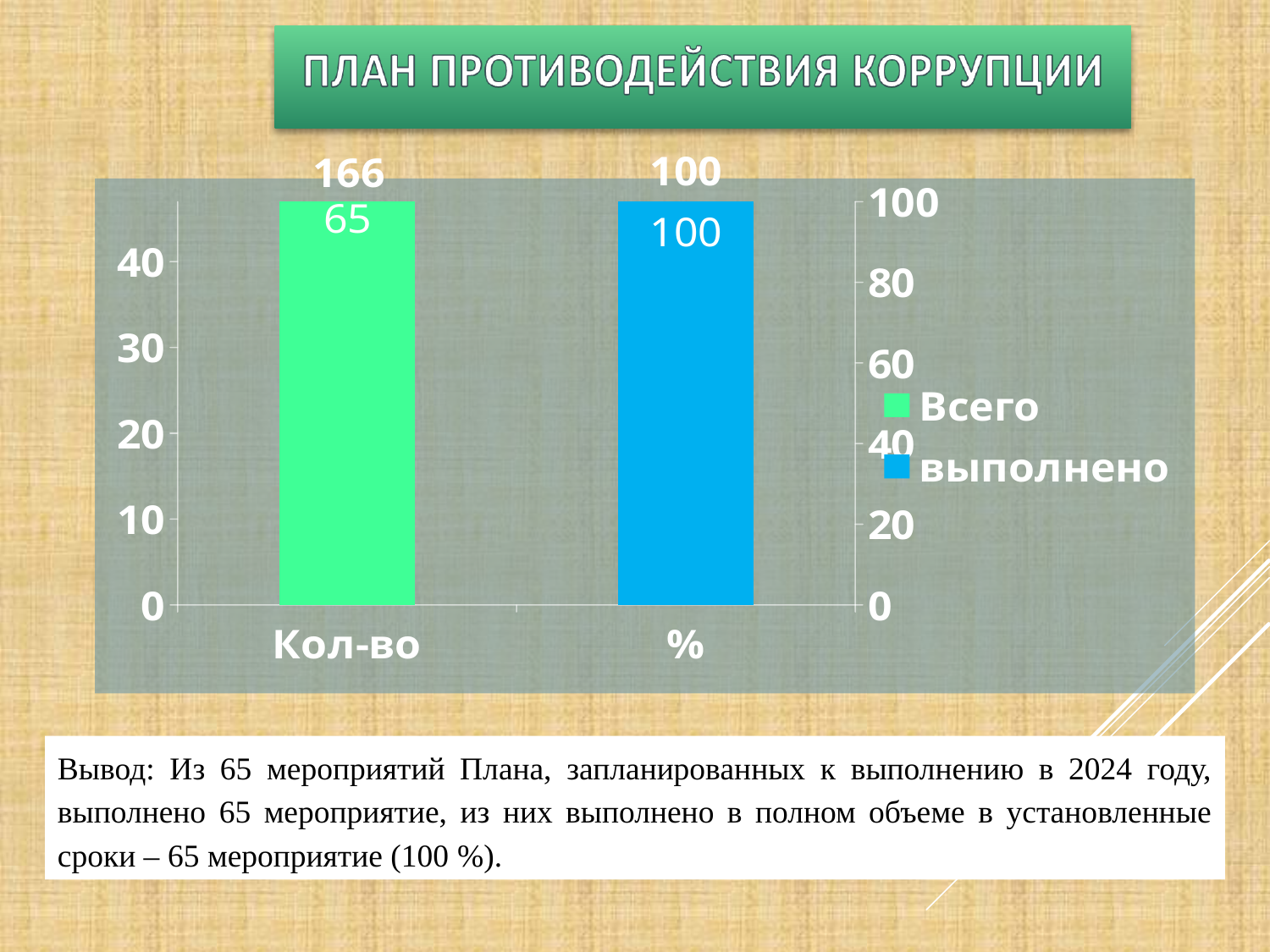
How many bars (categories) are plotted in the chart? 2 What is the title shown above the chart? ПЛАН ПРОТИВОДЕЙСТВИЯ КОРРУПЦИИ How many series does the chart legend list? 2 What kind of chart is shown on the slide? bar chart What are the category labels on the x axis of the chart? Кол-во, % What is the highest tick value shown on the left vertical axis? 40 What number is printed above the bar for the category "Кол-во"? 166 What value is printed inside the green bar for the category "Кол-во"? 65 What value is printed inside the bar for the category "%"? 100 Is the value for "Кол-во" greater or less than 40 on the left axis? greater